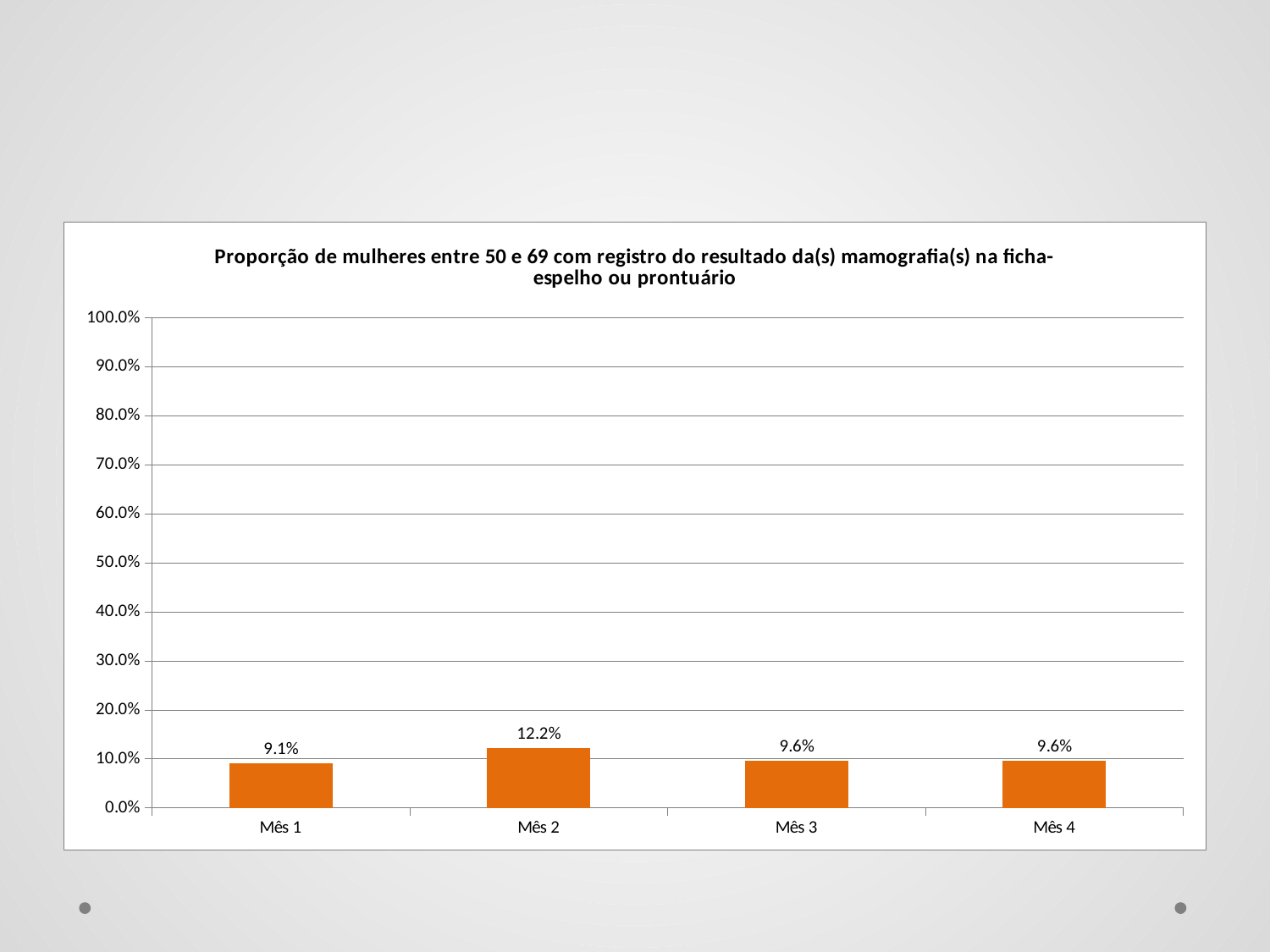
How many months are shown on the x axis? 4 Is the value for Mês 2 greater or less than 10.0%? greater What is the difference between the values for Mês 3 and Mês 1? 0.5% What kind of chart is shown on the slide? bar chart What is the highest value shown on the y axis? 100.0% What is the value for Mês 3? 9.6% What is the value for Mês 2? 12.2% What is the difference between the values for Mês 2 and Mês 1? 3.1% What is the value for Mês 1? 9.1% Which month has the lowest value? Mês 1 Which month has the highest value? Mês 2 Which is larger, the value for Mês 2 or the value for Mês 4? Mês 2